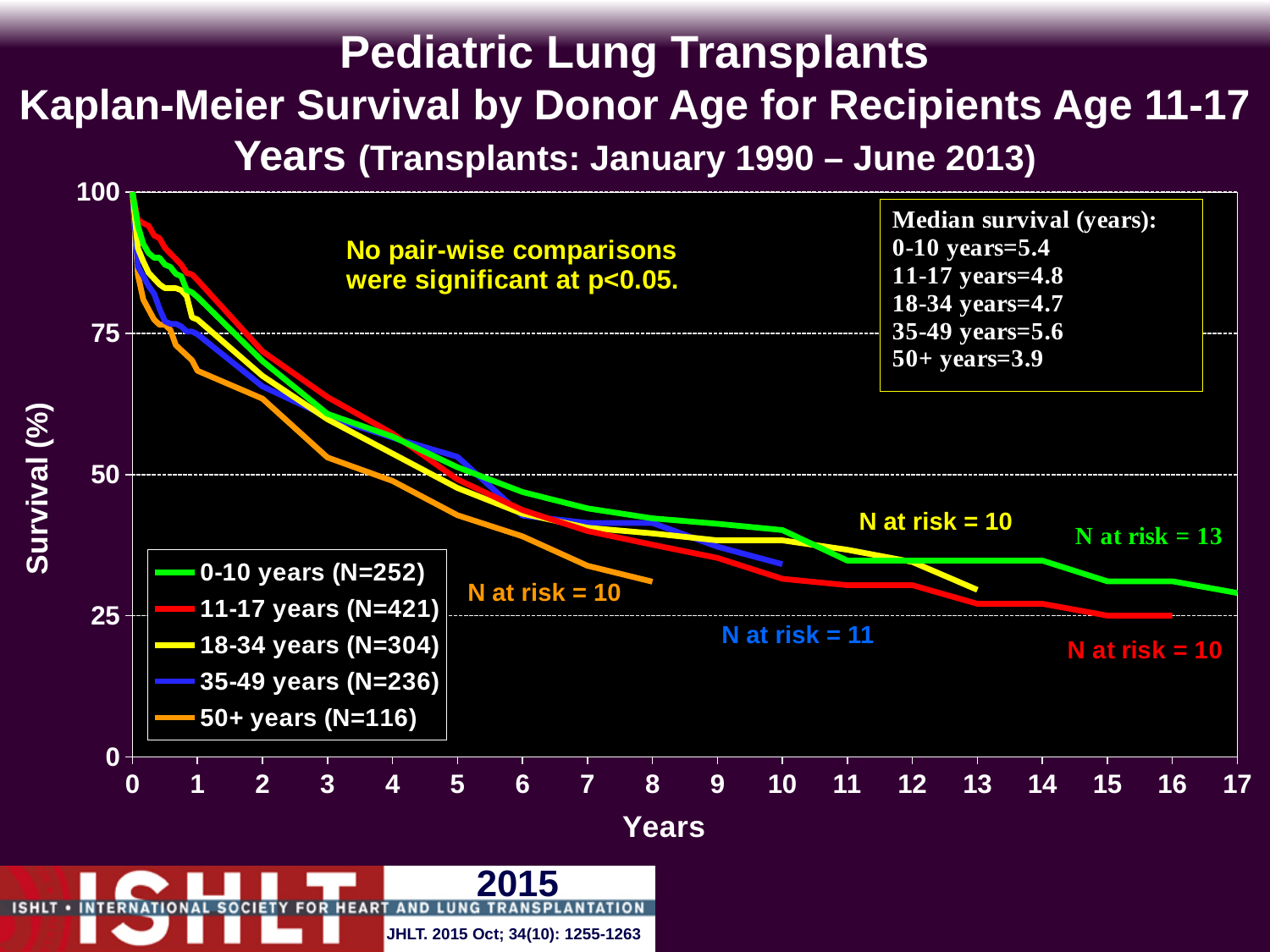
Which donor age group has the highest median survival? 35-49 years What is the label of the y-axis? Survival (%) How many donor age groups (series) does the legend list? 5 What is the N for the 11-17 years donor age group shown in the legend? 421 Is the survival for the 50+ years donor group at 8 years greater or less than 50%? less Do the survival curves rise or fall as years since transplant increase? fall What is the median survival in years for the 50+ years donor age group? 3.9 Which donor age group has the smallest N in the legend? 50+ years (N=116) What is the difference in median survival between the 0-10 years and 50+ years donor age groups? 1.5 years What is the median survival in years for the 0-10 years donor age group? 5.4 Which donor age group has the lowest median survival? 50+ years What kind of chart is shown on the slide? line chart